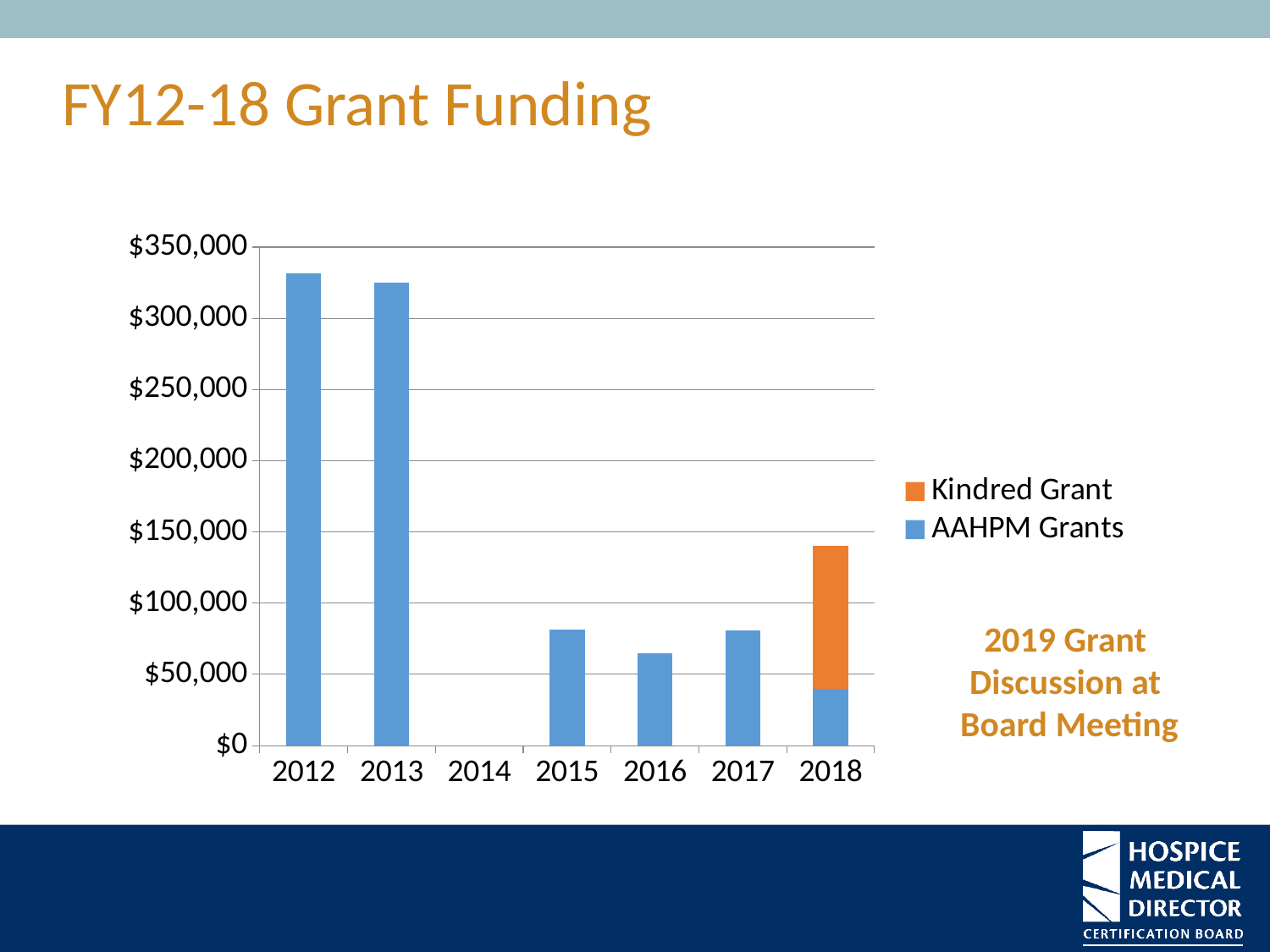
Is the value for 2015 greater or less than $100,000? less How many series does the legend list? 2 Is the total bar for 2018 greater or less than $100,000? greater What is the title of the slide containing the chart? FY12-18 Grant Funding Is the value for 2016 greater or less than $50,000? greater Which year shows no grant funding at all? 2014 What kind of chart is shown on the slide? Bar chart Which year has the larger total funding, 2013 or 2018? 2013 Which series does the legend show in orange? Kindred Grant How many years are shown on the x axis? 7